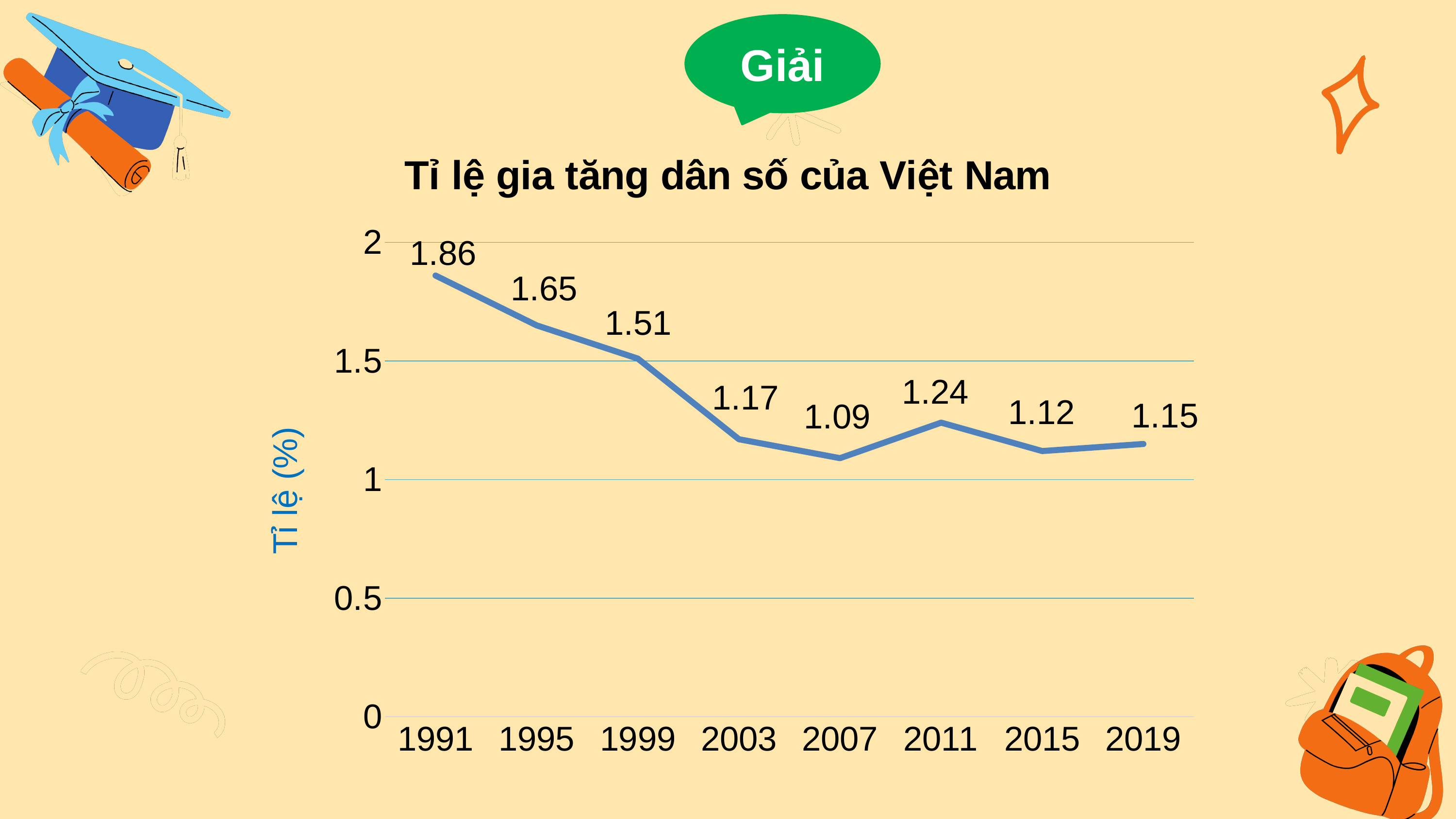
What is the difference between the values for 1991 and 2019? 0.71 What kind of chart is shown? line chart How many years are plotted on the chart? 8 Which year has the highest value? 1991 What is the value for 1991? 1.86 Is the value for 1999 greater or less than 1.5? greater Which year has the lowest value? 2007 What is the value for 2007? 1.09 What is the value for 2019? 1.15 What is the difference between the values for 2011 and 2007? 0.15 What is the title of the chart? Tỉ lệ gia tăng dân số của Việt Nam Which is larger, the value for 2011 or the value for 2015? 2011